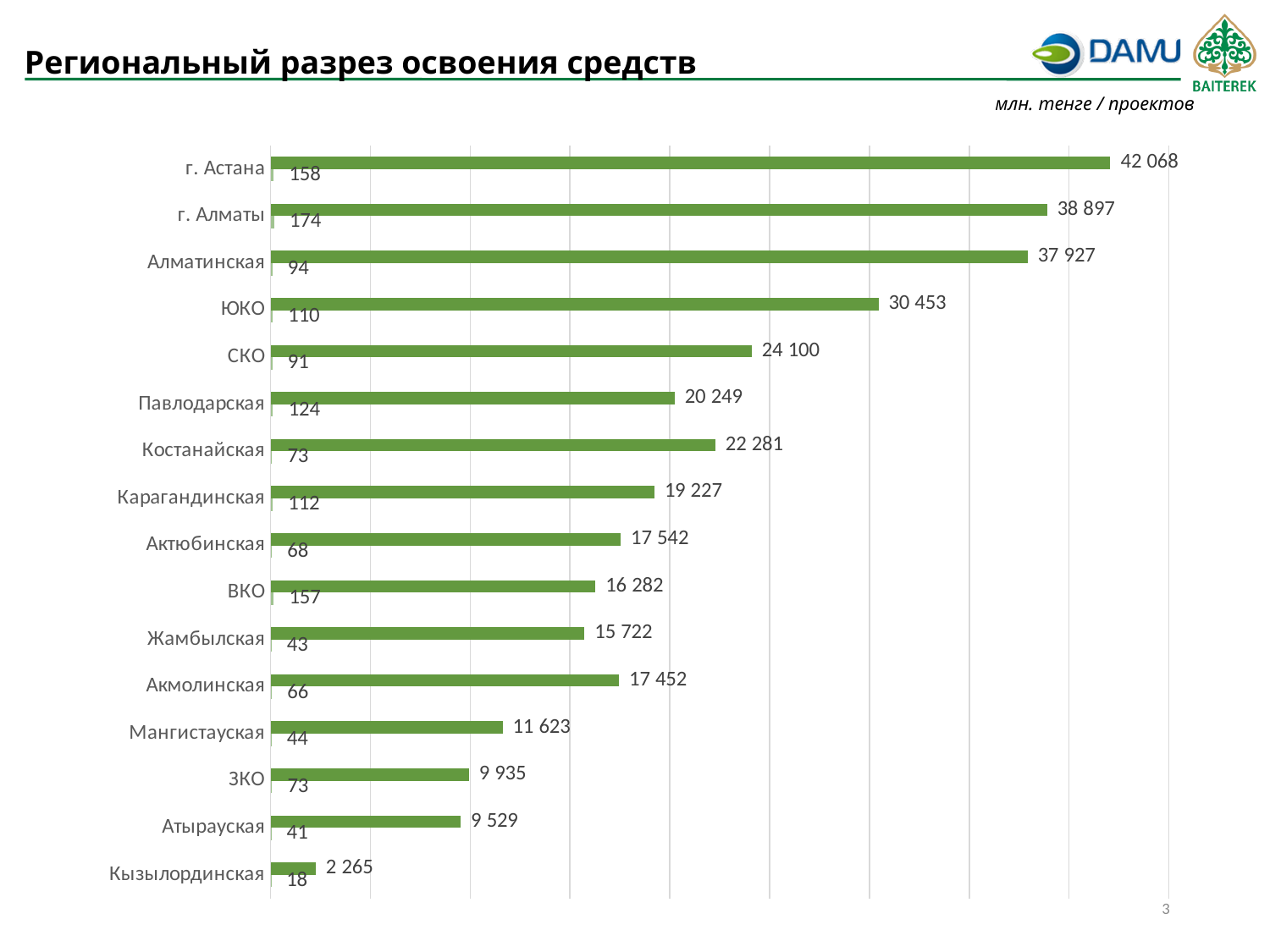
What is the difference in mln tenge between г. Астана and г. Алматы? 3 171 How many projects are shown for Павлодарская? 124 What is the amount in mln tenge for г. Астана? 42 068 Which region has the highest amount in mln tenge? г. Астана What is the difference in the number of projects between г. Алматы and Жамбылская? 131 How many regions are shown on the chart? 16 Which region has the lowest number of projects? Кызылординская What kind of chart is shown on the slide? Bar chart What units are indicated for the chart values? млн. тенге / проектов What is the amount in mln tenge for Кызылординская? 2 265 Which has the larger amount in mln tenge, Костанайская or Павлодарская? Костанайская Which has more projects, ВКО or Актюбинская? ВКО